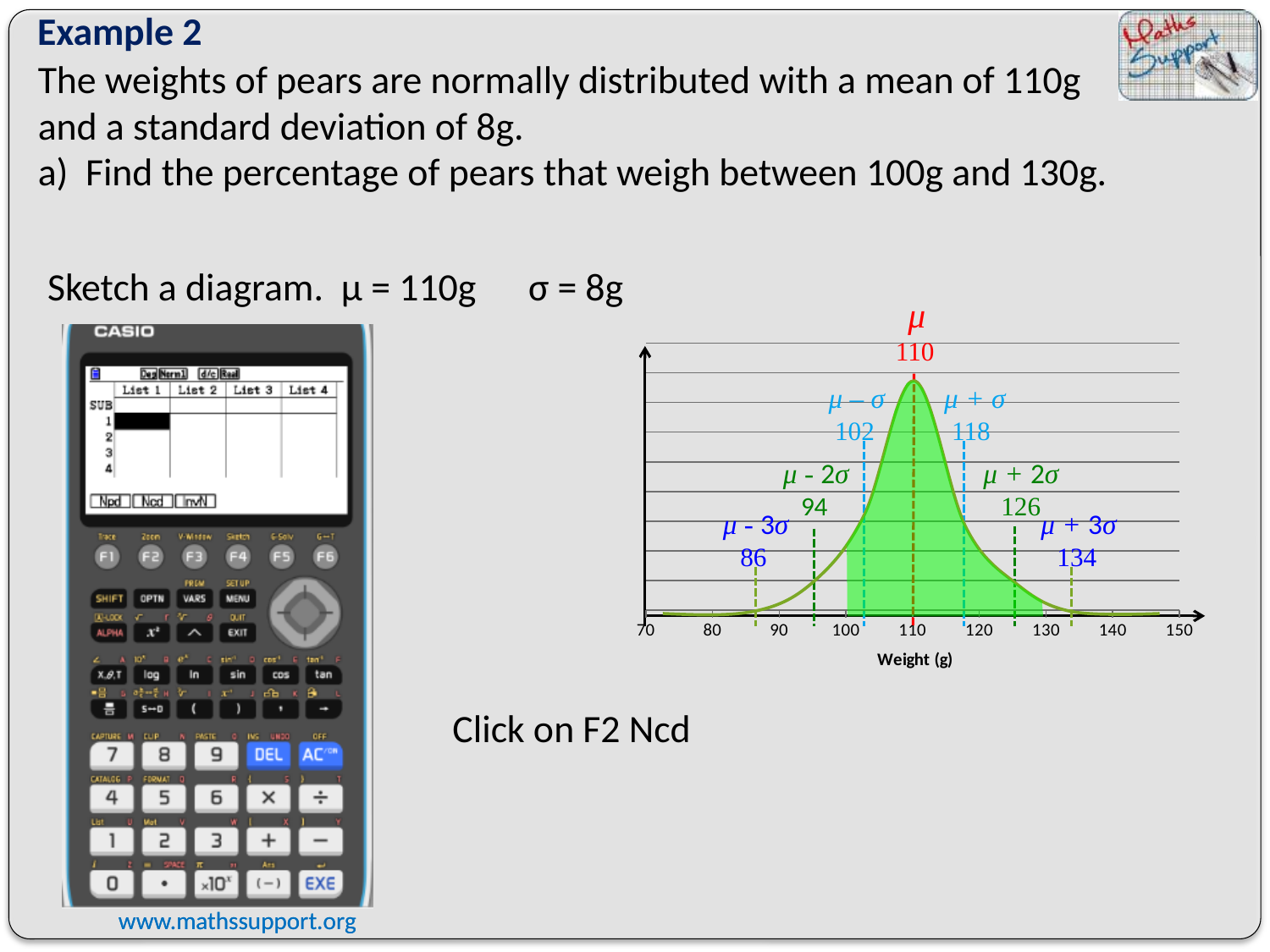
At which weight does the curve on the chart reach its peak? 110 What value is labelled at μ - 2σ on the chart? 94 What value is labelled at μ + σ on the chart? 118 What is the title of the horizontal axis on the chart? Weight (g) What is the lowest tick value shown on the horizontal axis of the chart? 70 What value is labelled at μ – σ on the chart? 102 What value is labelled at μ + 3σ on the chart? 134 What value is labelled at μ on the chart? 110 What value is labelled at μ + 2σ on the chart? 126 What is the highest tick value shown on the horizontal axis of the chart? 150 What value is labelled at μ - 3σ on the chart? 86 What is the difference between the values labelled at μ + σ and μ – σ on the chart? 16